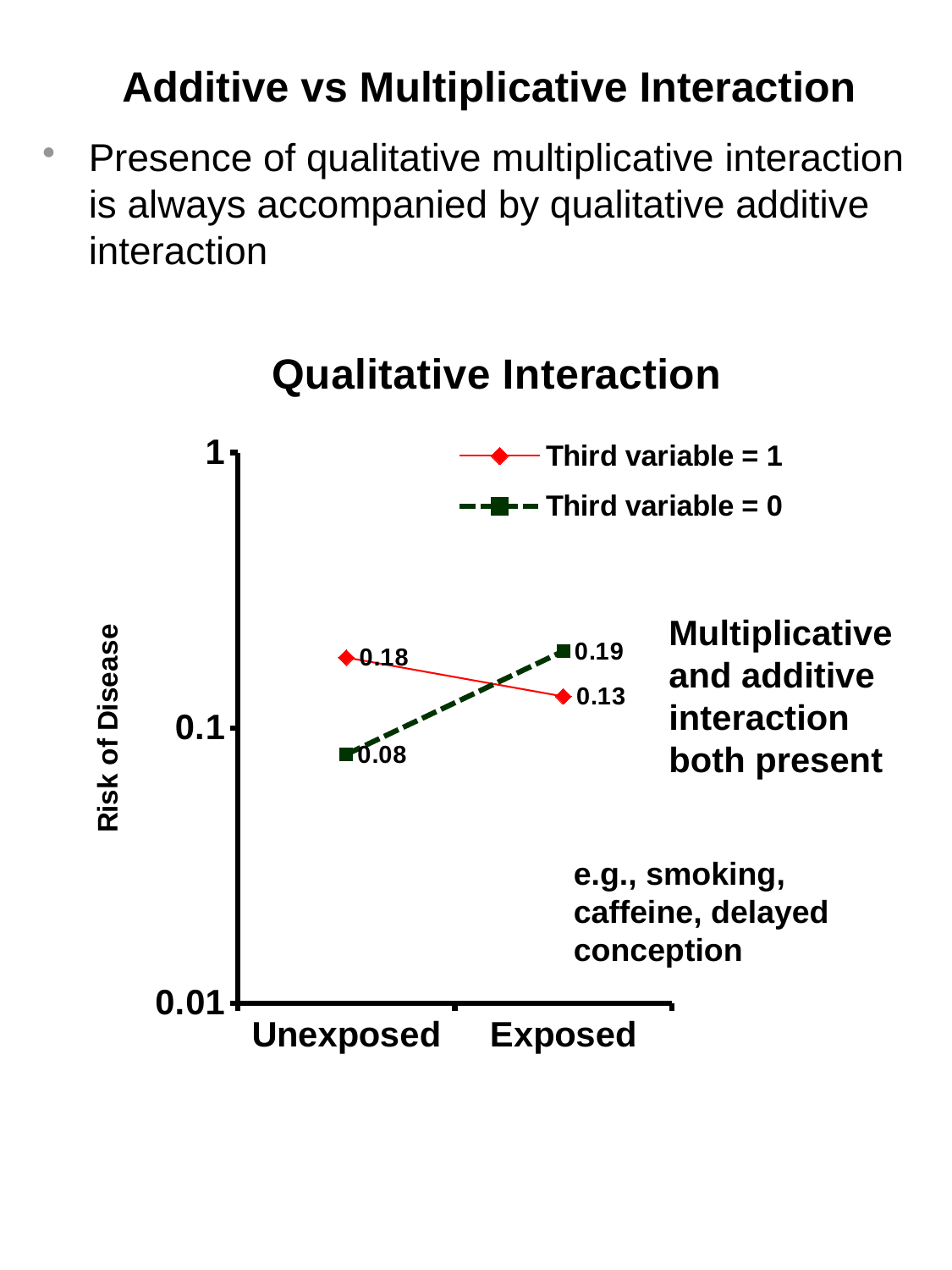
Which series has the lower risk of disease in the Unexposed group? Third variable = 0 What is the risk of disease for the Exposed group when Third variable = 0? 0.19 Which series has the higher risk of disease in the Exposed group? Third variable = 0 Does the risk of disease for Third variable = 1 rise or fall from Unexposed to Exposed? fall What is the risk of disease for the Unexposed group when Third variable = 1? 0.18 What is the difference in risk of disease between Exposed and Unexposed for Third variable = 0? 0.11 Does the risk of disease for Third variable = 0 rise or fall from Unexposed to Exposed? rise What is the title of the chart? Qualitative Interaction What is the difference in risk of disease between Unexposed and Exposed for Third variable = 1? 0.05 What is the risk of disease for the Unexposed group when Third variable = 0? 0.08 What is the risk of disease for the Exposed group when Third variable = 1? 0.13 How many series does the legend list? 2